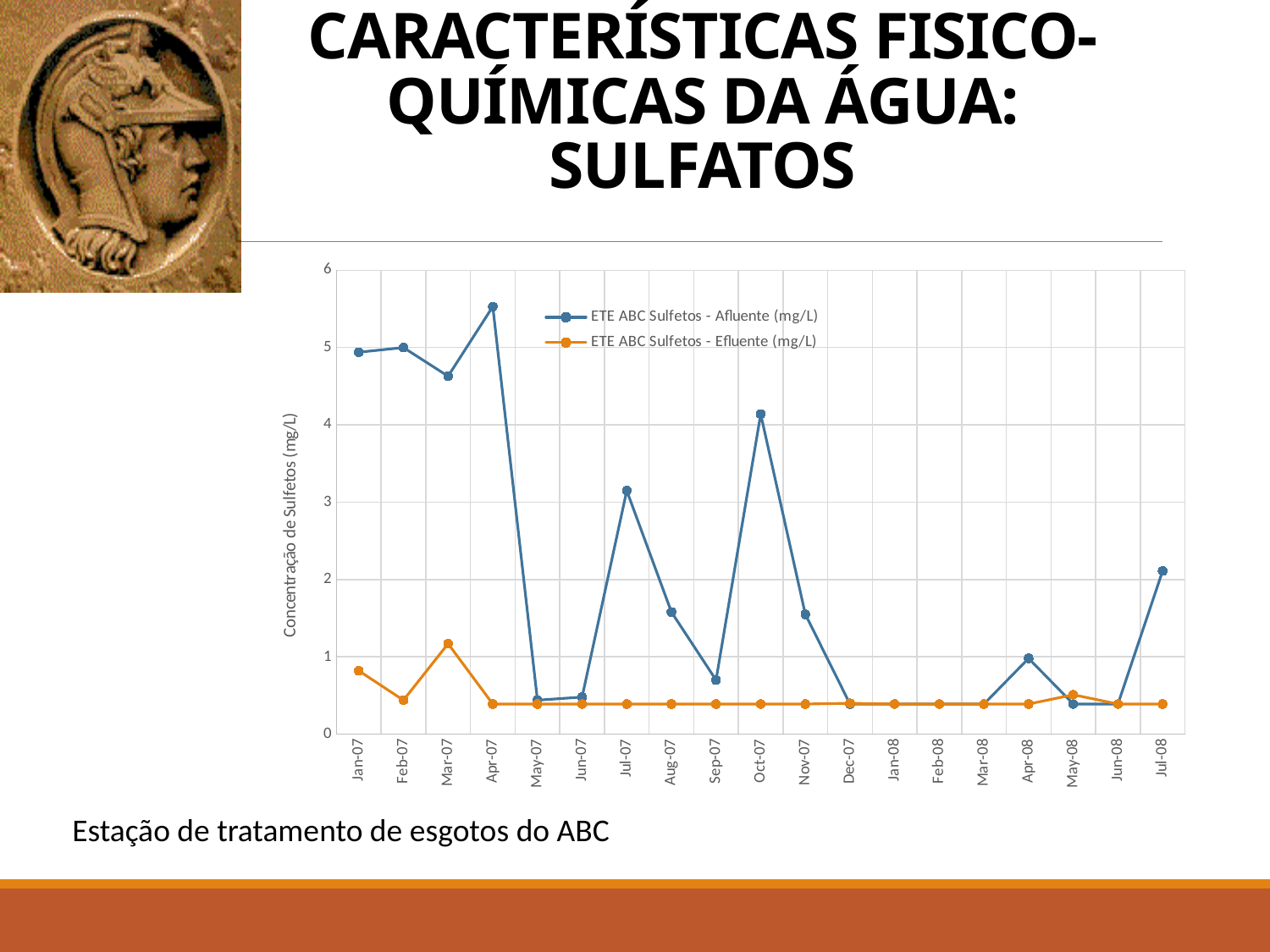
How many series does the legend list? 2 What kind of chart is shown on the slide? Line chart Does the ETE ABC Sulfetos - Afluente (mg/L) series rise or fall from Oct-07 to Dec-07? Fall Is the value for ETE ABC Sulfetos - Afluente (mg/L) in Oct-07 greater or less than 4? greater Is the value for ETE ABC Sulfetos - Efluente (mg/L) in Mar-07 greater or less than 1? greater How many months are plotted along the x axis? 19 Which series has the larger value in Oct-07, Afluente or Efluente? Afluente In which month does the ETE ABC Sulfetos - Afluente (mg/L) series reach its highest value? Apr-07 In which month does the ETE ABC Sulfetos - Efluente (mg/L) series reach its highest value? Mar-07 What is the title of the vertical axis? Concentração de Sulfetos (mg/L) Is the value for ETE ABC Sulfetos - Afluente (mg/L) in Aug-07 greater or less than 2? less